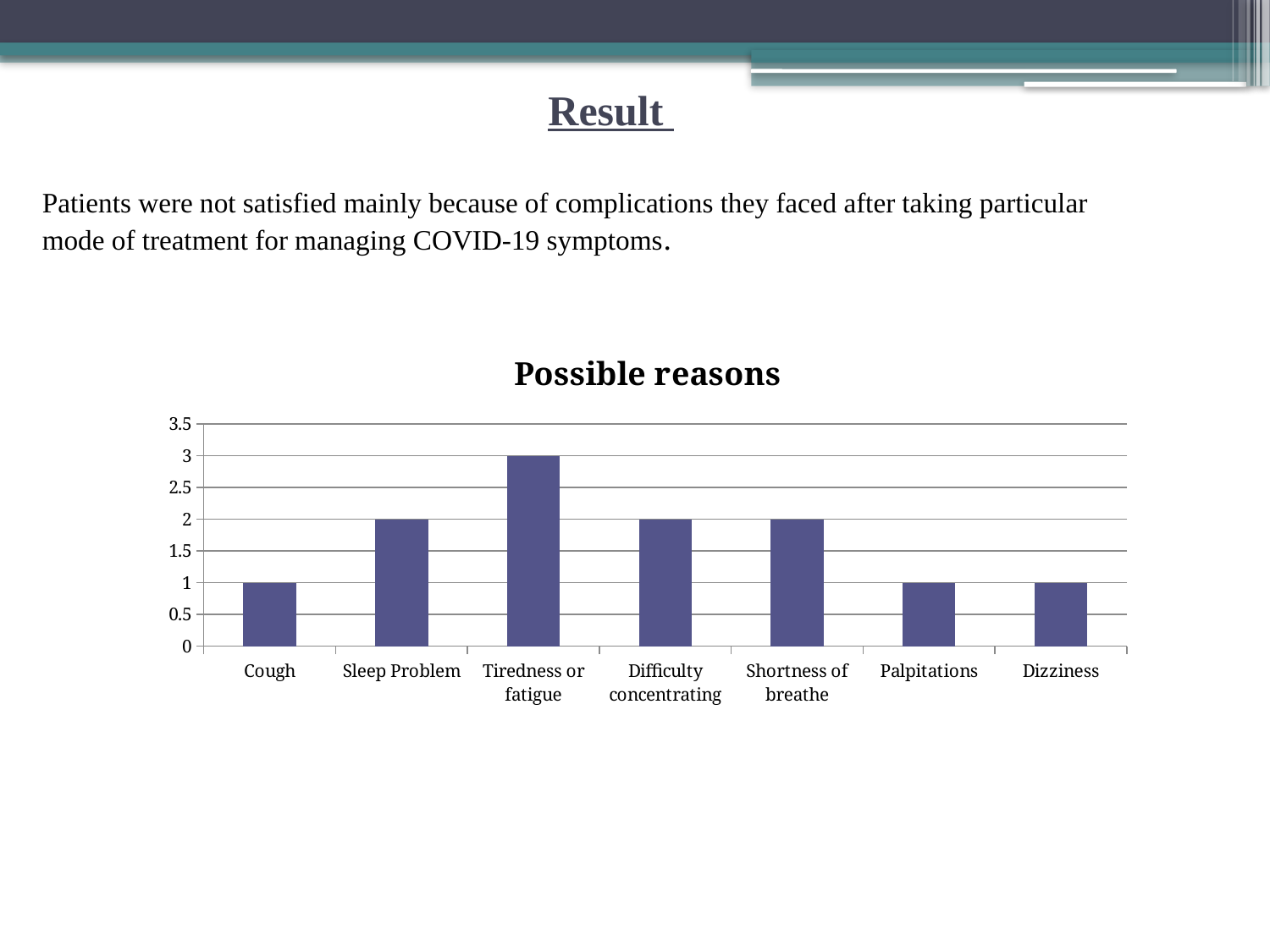
What is the value for Tiredness or fatigue? 3 What is the difference between the values for Shortness of breathe and Palpitations? 1 What is the value for Cough? 1 What is the difference between the values for Tiredness or fatigue and Cough? 2 What is the title of the chart? Possible reasons Which category has the highest value? Tiredness or fatigue What kind of chart is shown on the slide? bar chart What is the value for Sleep Problem? 2 What is the value for Dizziness? 1 How many categories are shown on the x axis? 7 Is the value for Tiredness or fatigue greater or less than 2.5? greater Which is larger, the value for Sleep Problem or the value for Palpitations? Sleep Problem